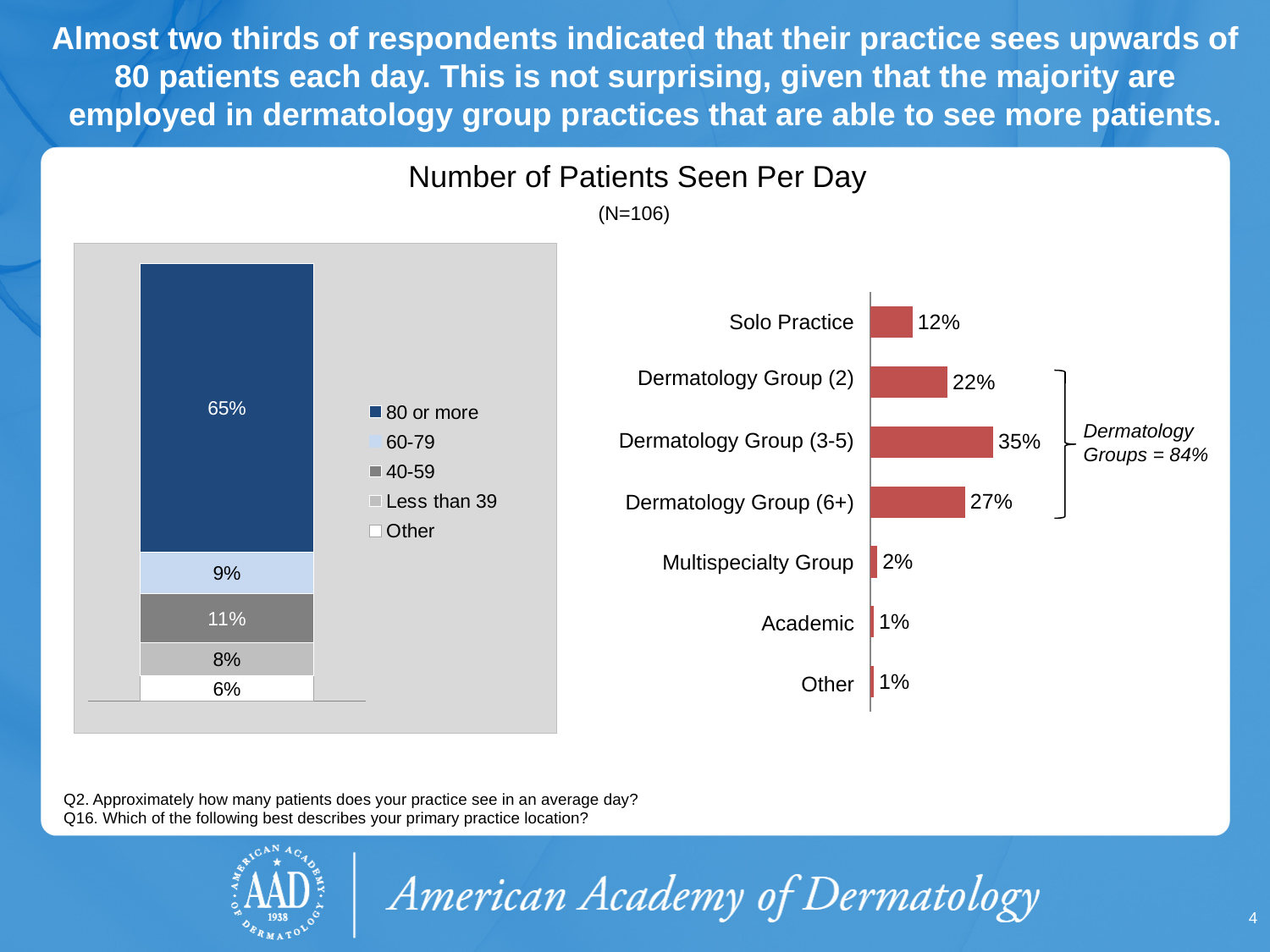
In the stacked bar chart on the left, what is the total of all the segments in the bar? 99% In the horizontal bar chart on the right, which is larger: Dermatology Group (2) or Dermatology Group (6+)? Dermatology Group (6+) What kind of chart is shown on the right side of the slide? Bar chart In the stacked bar chart on the left, what percentage of respondents see 40-59 patients per day? 11% In the stacked bar chart on the left, how many series does the legend list? 5 In the horizontal bar chart on the right, which category has the highest value? Dermatology Group (3-5) In the stacked bar chart on the left, which category has the smallest share? Other In the horizontal bar chart on the right, what is the value for Dermatology Group (3-5)? 35% In the horizontal bar chart on the right, what is the value for Solo Practice? 12% In the horizontal bar chart on the right, how many categories are shown? 7 In the stacked bar chart on the left, what percentage of respondents see 80 or more patients per day? 65% In the stacked bar chart on the left, what is the difference between the 80 or more share and the 60-79 share? 56%